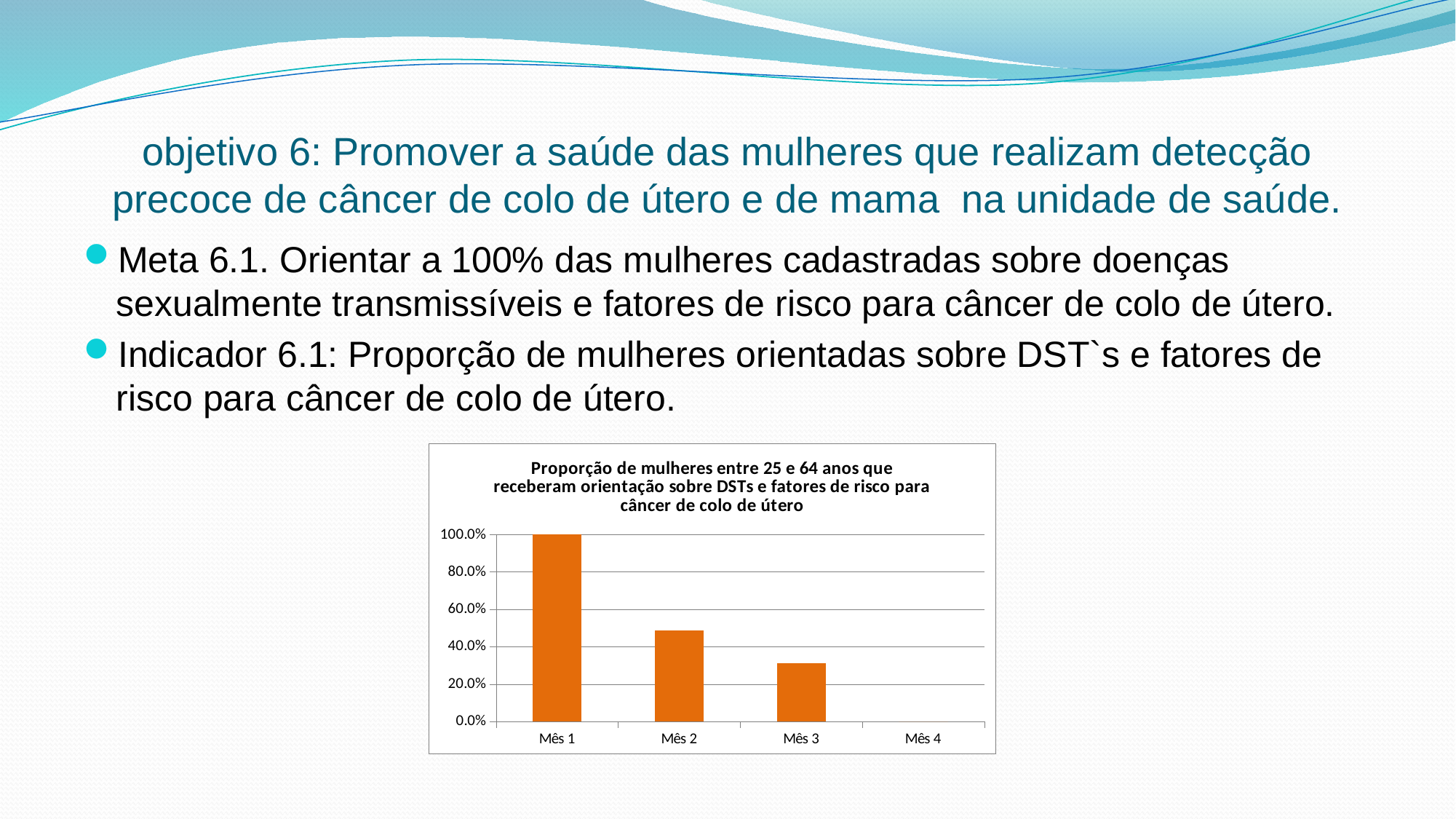
Is the value for Mês 2 greater or less than 40.0%? greater Do the values rise or fall from Mês 1 to Mês 3? fall Is the value for Mês 3 greater or less than 20.0%? greater Which is larger, the value for Mês 2 or the value for Mês 3? Mês 2 What colour are the bars in the chart? orange Is the value for Mês 3 greater or less than 40.0%? less Which month has the highest value in the chart? Mês 1 What kind of chart is shown on the slide? bar chart What is the title of the chart? Proporção de mulheres entre 25 e 64 anos que receberam orientação sobre DSTs e fatores de risco para câncer de colo de útero How many categories (months) are shown on the x axis of the chart? 4 What is the value for Mês 1 in the chart? 100.0%